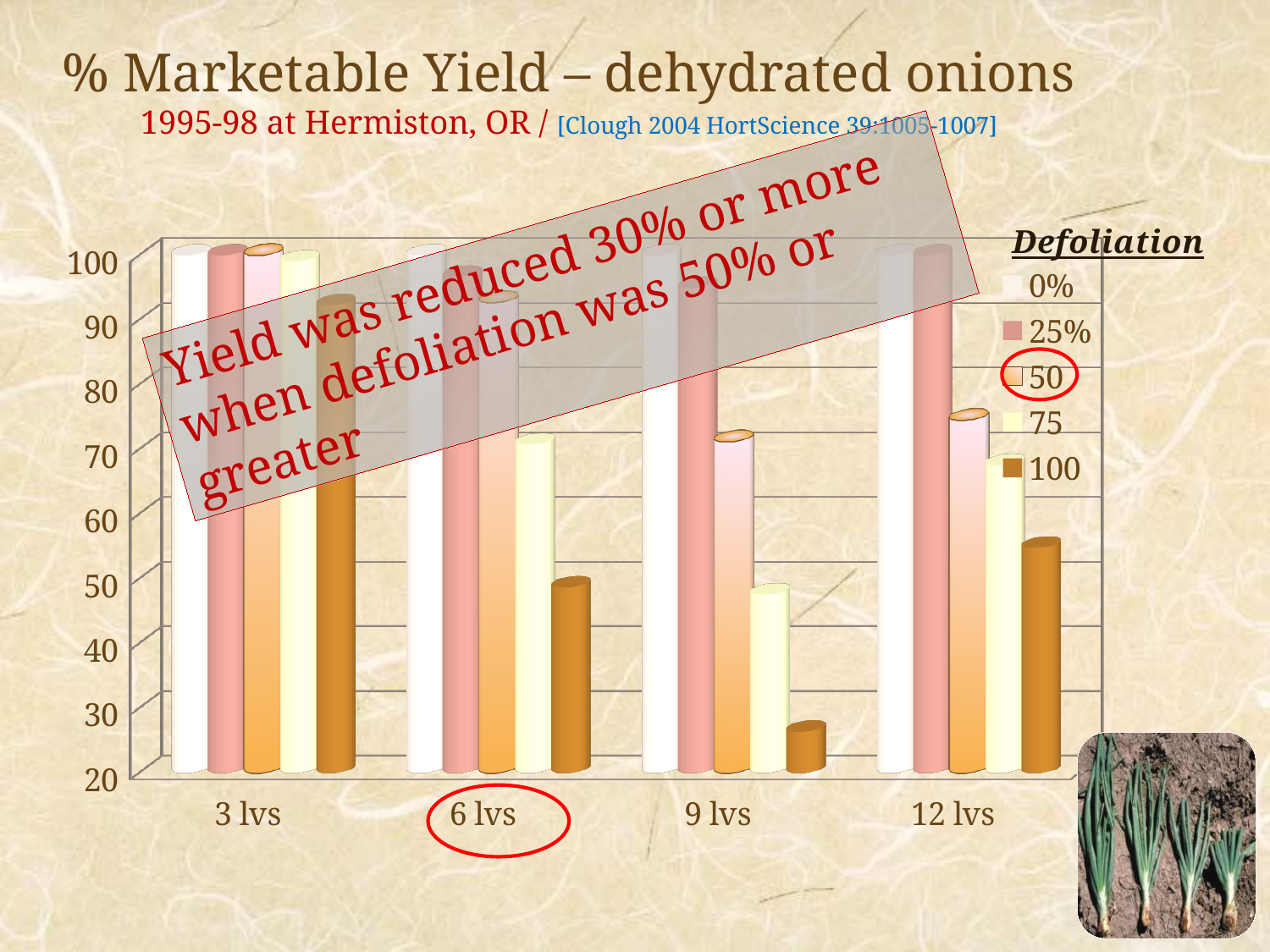
How many leaf-stage categories are shown on the x axis? 4 Is the value for 100% defoliation at 3 lvs greater or less than 80? greater Within the 9 lvs group, which defoliation level has the lowest marketable yield? 100 Which x-axis category is circled in red? 6 lvs How many defoliation series does the legend list? 5 Which is larger: the 100% defoliation value at 12 lvs or the 100% defoliation value at 9 lvs? 12 lvs Within the 6 lvs group, do the bars rise or fall as defoliation increases from 0% to 100? fall Is the value for 100% defoliation at 9 lvs greater or less than 30? less What kind of chart is shown on the slide? bar chart Is the value for 100% defoliation at 6 lvs greater or less than 60? less What is the title of the legend? Defoliation